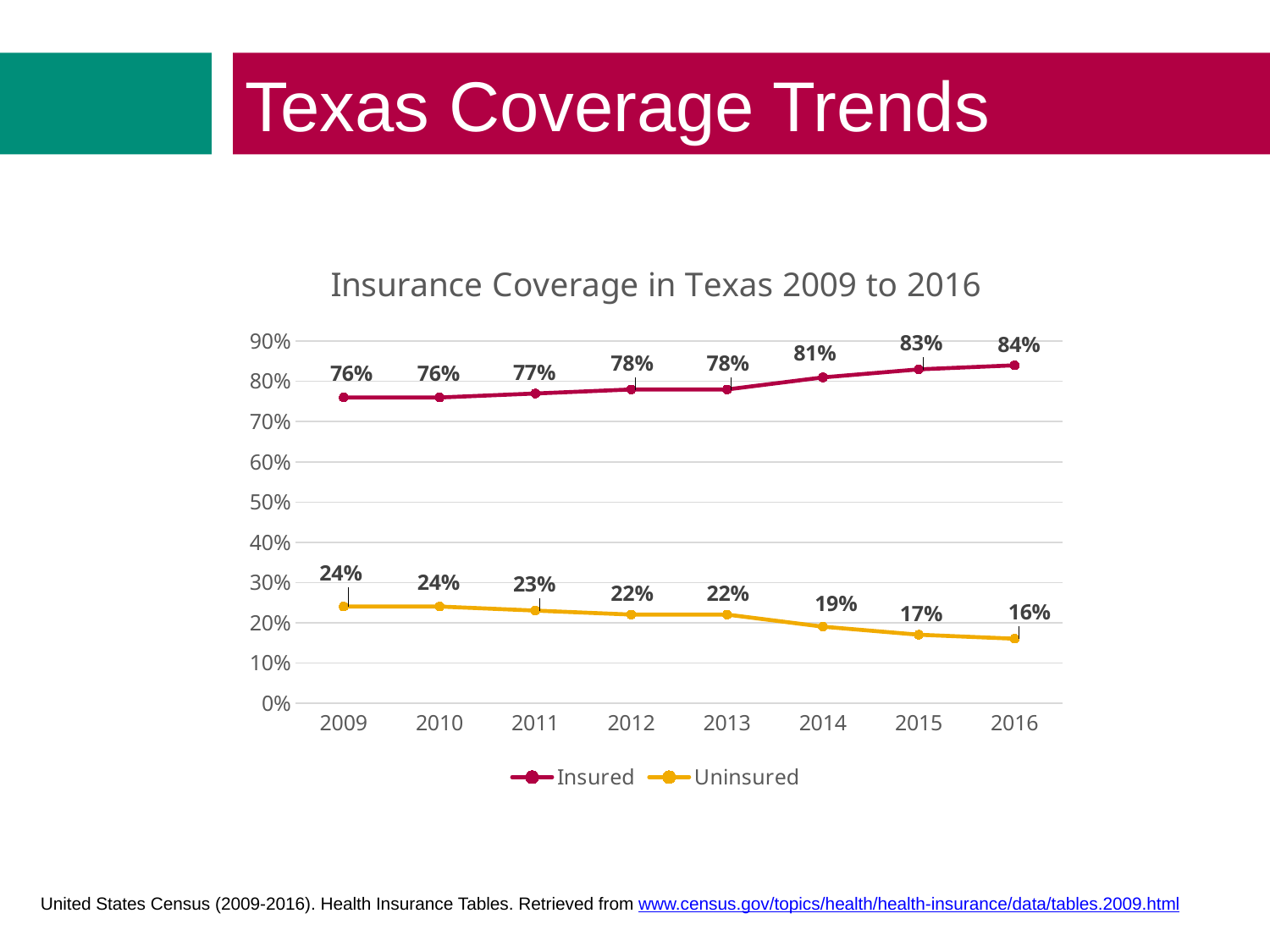
Does the Uninsured series rise or fall from 2009 to 2016? Fall In which year is the Insured value highest? 2016 How many years are shown on the x axis? 8 What is the Uninsured value for 2011? 23% What is the title of the chart? Insurance Coverage in Texas 2009 to 2016 How many series does the legend list? 2 What is the difference between the Insured values for 2016 and 2009? 8% What is the difference between the Uninsured values for 2009 and 2016? 8% Which is larger, the Uninsured value for 2013 or for 2015? 2013 In which year is the Uninsured value lowest? 2016 What is the Insured value for 2014? 81% What kind of chart is shown? Line chart